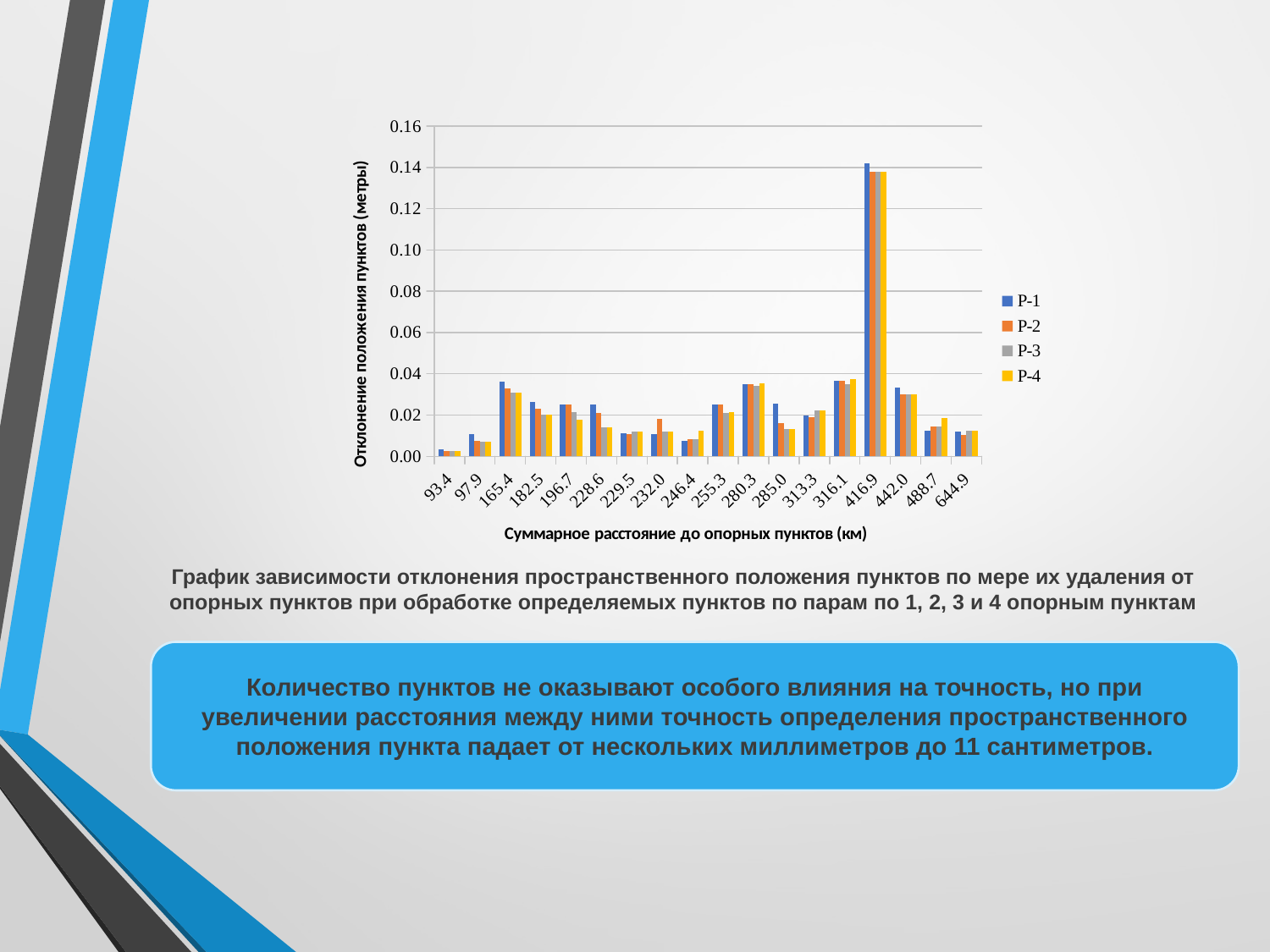
Is the value of Р-1 for category 165.4 greater or less than 0.02? greater What kind of chart is shown on the slide? bar chart Is the value of Р-1 for category 416.9 greater or less than 0.12? greater Which category has the highest values across all series? 416.9 What is the title of the vertical axis? Отклонение положения пунктов (метры) Is the value of Р-1 for category 93.4 greater or less than 0.02? less Which category has the lowest values across all series? 93.4 How many series does the legend list? 4 How many categories are shown along the x axis? 18 What is the title of the horizontal axis? Суммарное расстояние до опорных пунктов (км) Which is larger: the value of Р-1 for category 416.9 or for category 442.0? 416.9